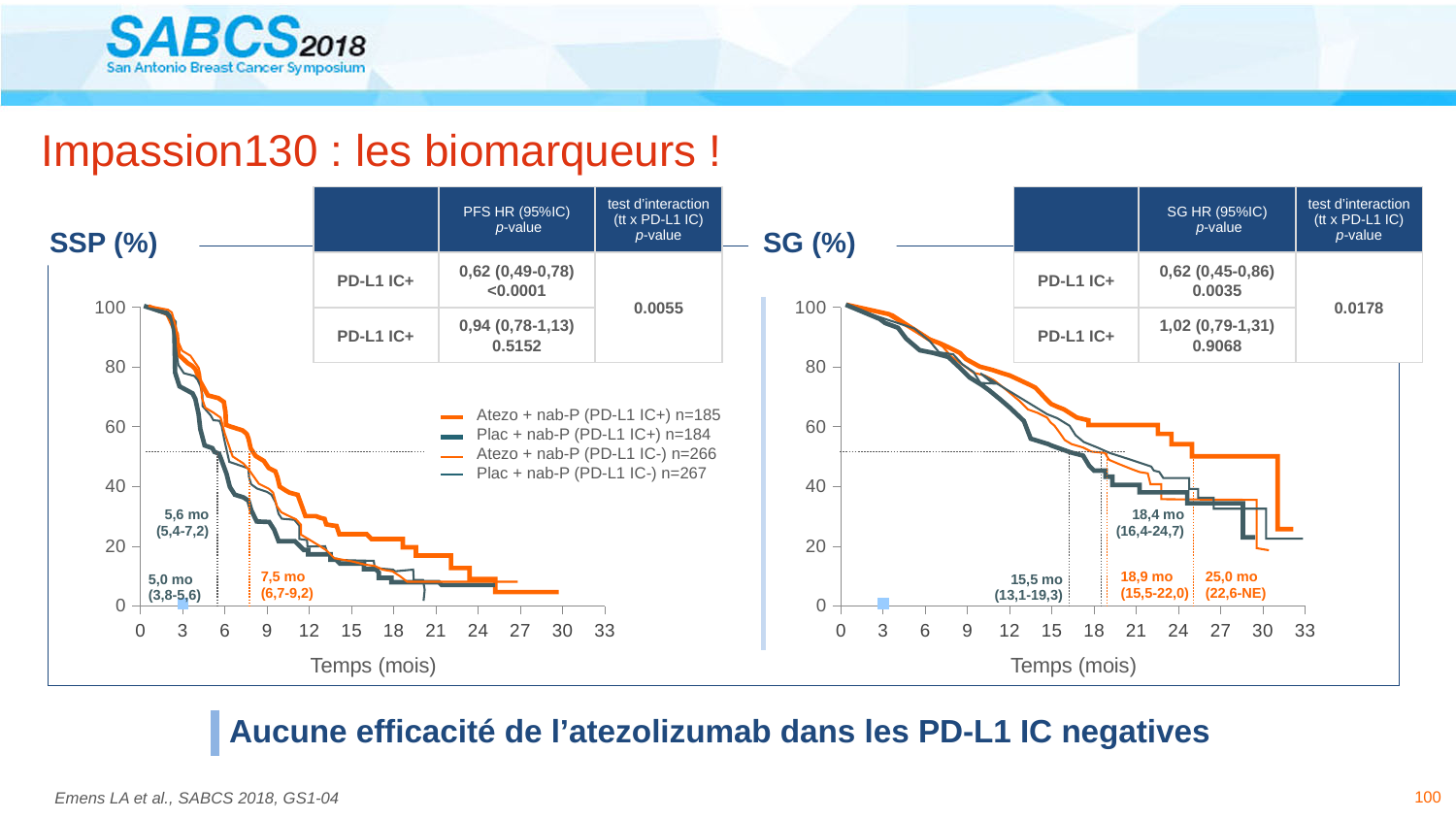
What kind of chart is the SSP (%) chart on the left? line chart On the SG (%) chart, what is the confidence interval printed under the 18,4 mo median? (16,4-24,7) On the SSP (%) chart, what is the largest median time printed on the chart? 7,5 mo How many series does the legend of the SSP (%) chart list? 4 On the SSP (%) chart, how many patients (n) are in the Plac + nab-P (PD-L1 IC-) group according to the legend? n=267 On the SSP (%) chart, what is the smallest median time printed on the chart? 5,0 mo On the SSP (%) chart, what is the highest tick value shown on the x axis? 33 On the SG (%) chart, what is the largest median time printed on the chart? 25,0 mo On the SSP (%) chart, how many patients (n) are in the Atezo + nab-P (PD-L1 IC+) group according to the legend? n=185 On the SSP (%) chart, what is the x-axis label? Temps (mois) On the SSP (%) chart, do the survival curves rise or fall as time increases along the x axis? fall On the SG (%) chart, what is the smallest median time printed on the chart? 15,5 mo